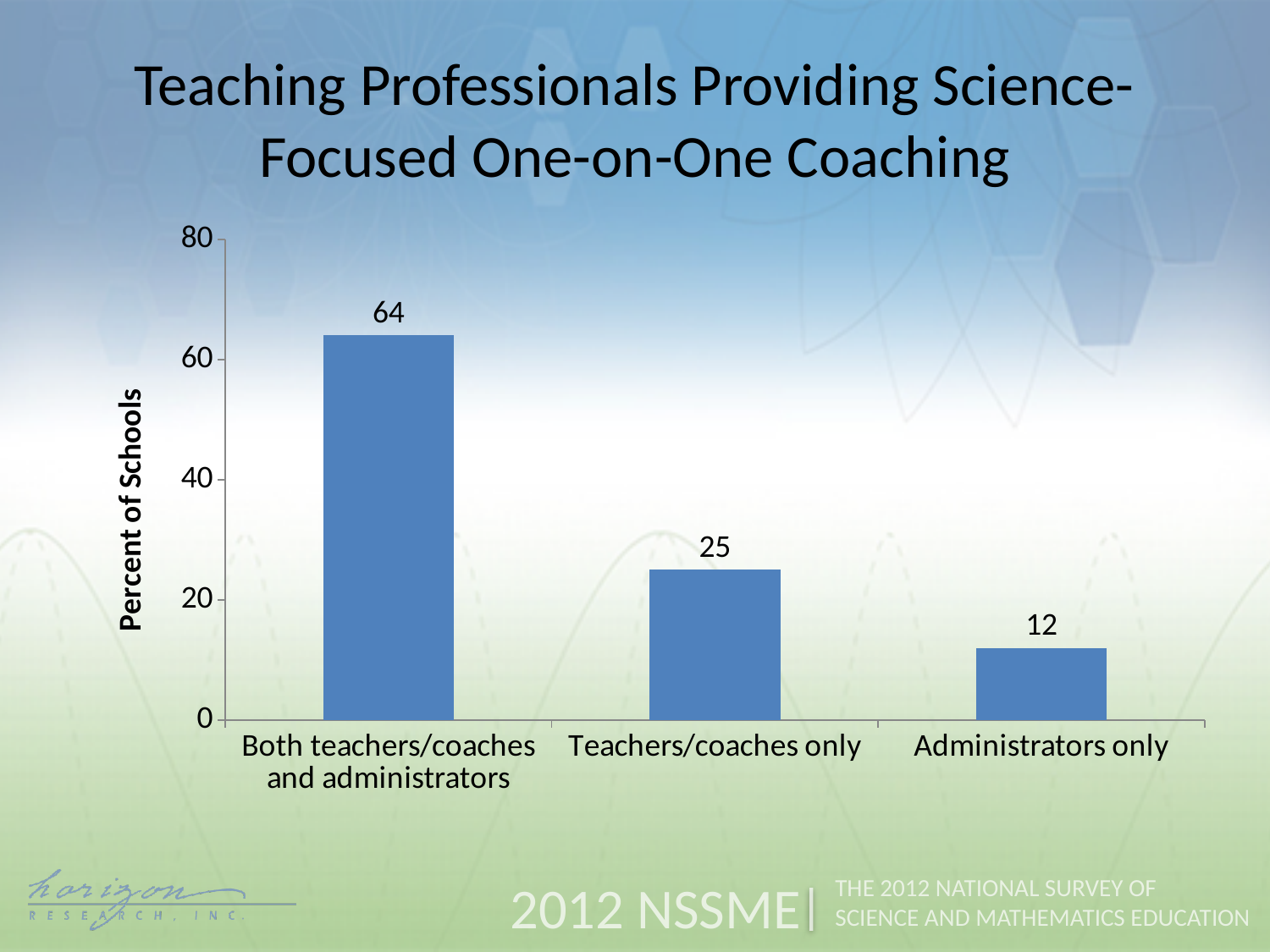
What is the difference between the values for Teachers/coaches only and Administrators only? 13 What kind of chart is shown on the slide? bar chart What is the label of the vertical axis? Percent of Schools Which category has the highest value? Both teachers/coaches and administrators How many categories are shown on the x axis? 3 Which category has the lowest value? Administrators only What is the value for Administrators only? 12 What is the value for Both teachers/coaches and administrators? 64 What is the difference between the values for Both teachers/coaches and administrators and Teachers/coaches only? 39 What is the value for Teachers/coaches only? 25 Which is larger, the value for Teachers/coaches only or Administrators only? Teachers/coaches only Is the value for Both teachers/coaches and administrators greater or less than 60? greater